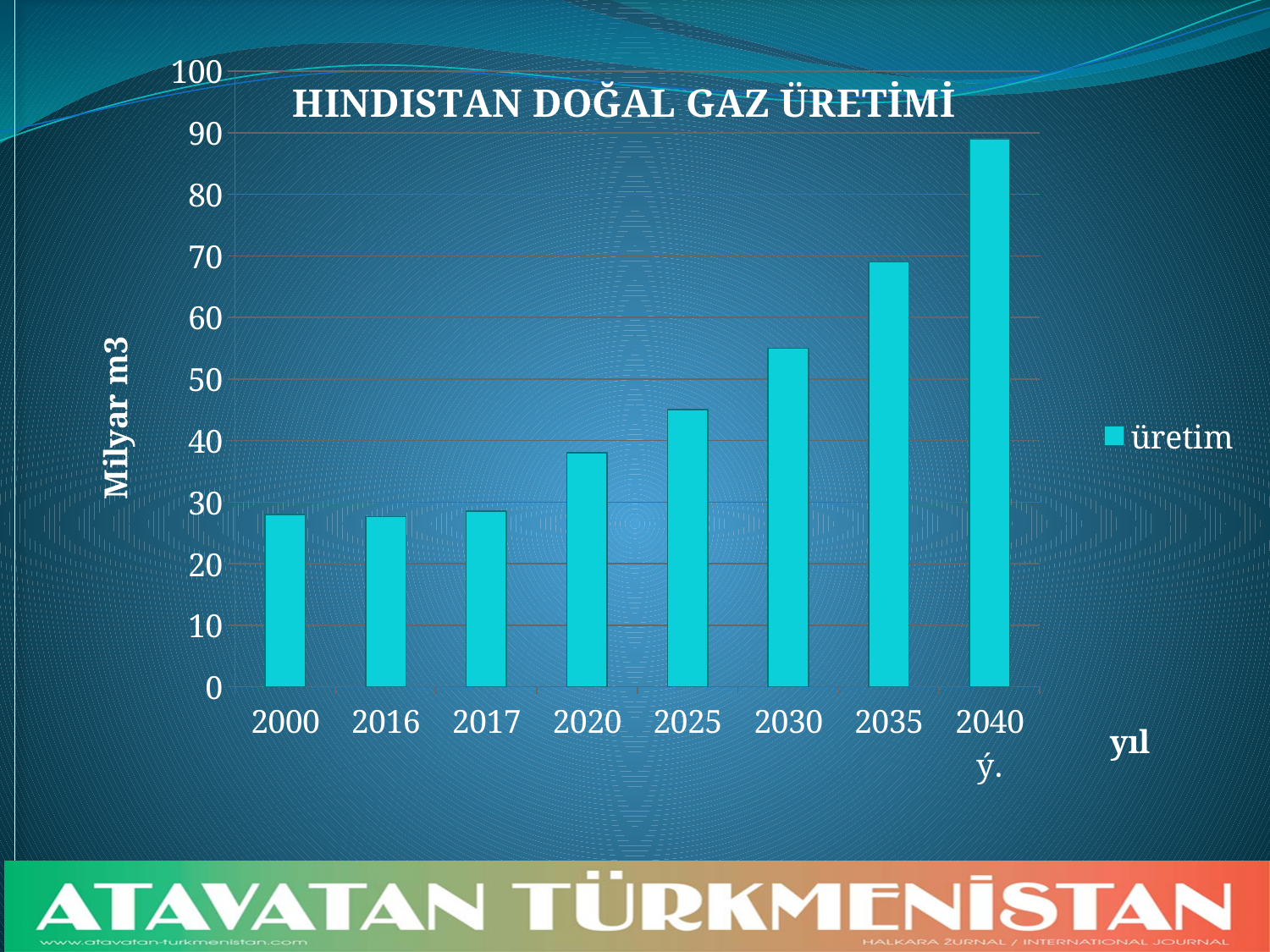
What is the title of the chart? HINDISTAN DOĞAL GAZ ÜRETİMİ Is the value for 2030 greater or less than 50? greater Is the value for 2025 greater or less than 40? greater Is the value for 2040 greater or less than 80? greater Which year has the highest production value? 2040 How many year categories are shown on the x axis? 8 Do the values generally rise or fall from 2017 to 2040? rise What type of chart is shown on the slide? bar chart Which is larger, the value for 2030 or the value for 2025? 2030 How many series does the legend list? 1